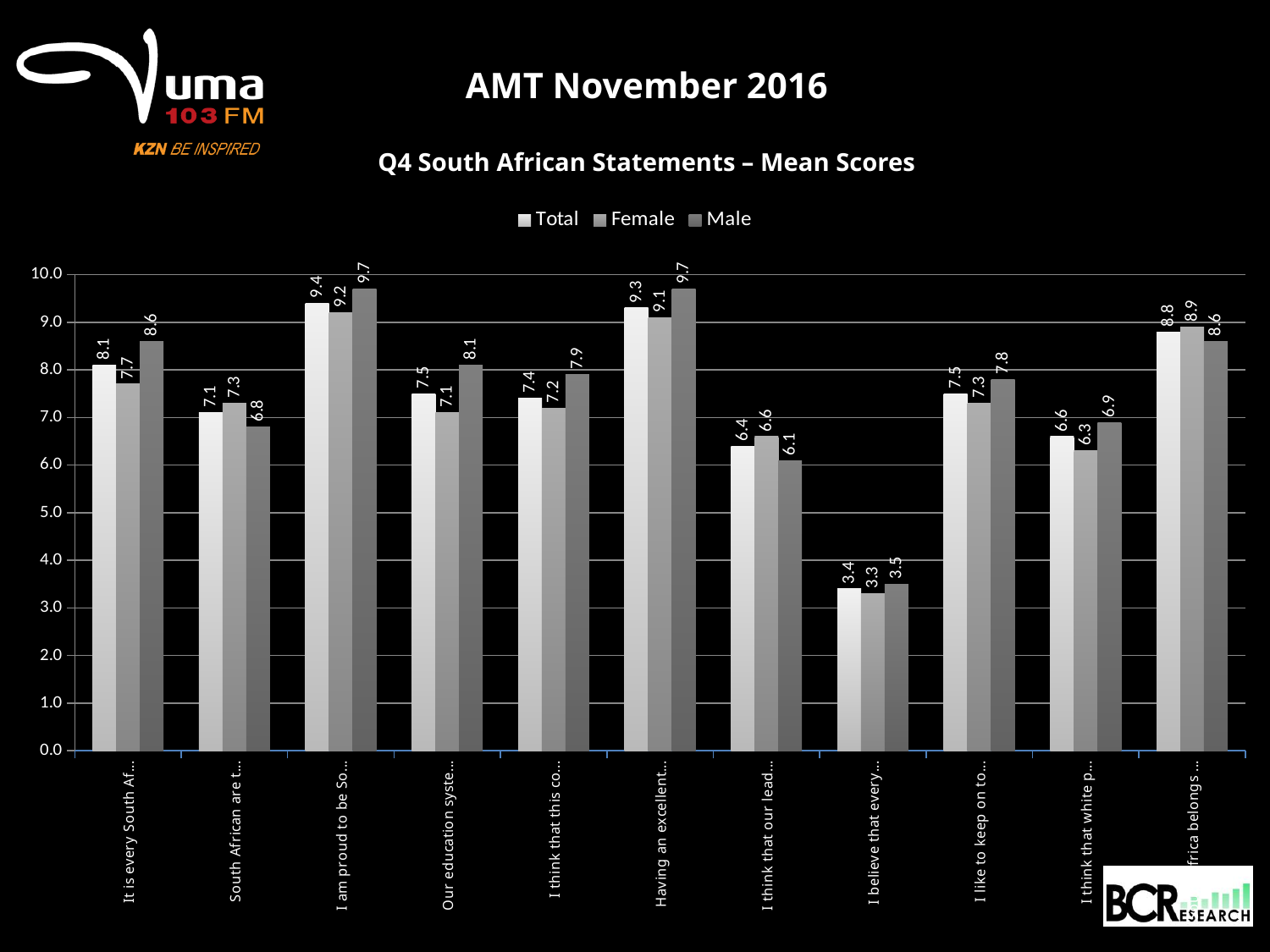
What is the difference between the Male and Female mean scores for the statement beginning "It is every South Af..."? 0.9 Which statement has the lowest Total mean score? I believe that every... What is the Female mean score for the statement beginning "I think that our lead..."? 6.6 How many statements (categories) are plotted on the chart? 11 Is the Total mean score for the statement beginning "I believe that every..." greater or less than 4.0? less Which statement has the highest Total mean score? I am proud to be So... What is the title of the chart? Q4 South African Statements – Mean Scores What is the Total mean score for the statement beginning "I am proud to be So..."? 9.4 What is the Male mean score for the statement beginning "Our education syste..."? 8.1 How many series does the legend list? 3 What type of chart is shown on the slide? bar chart For the statement beginning "South African are t...", which is larger, the Female or the Male mean score? Female